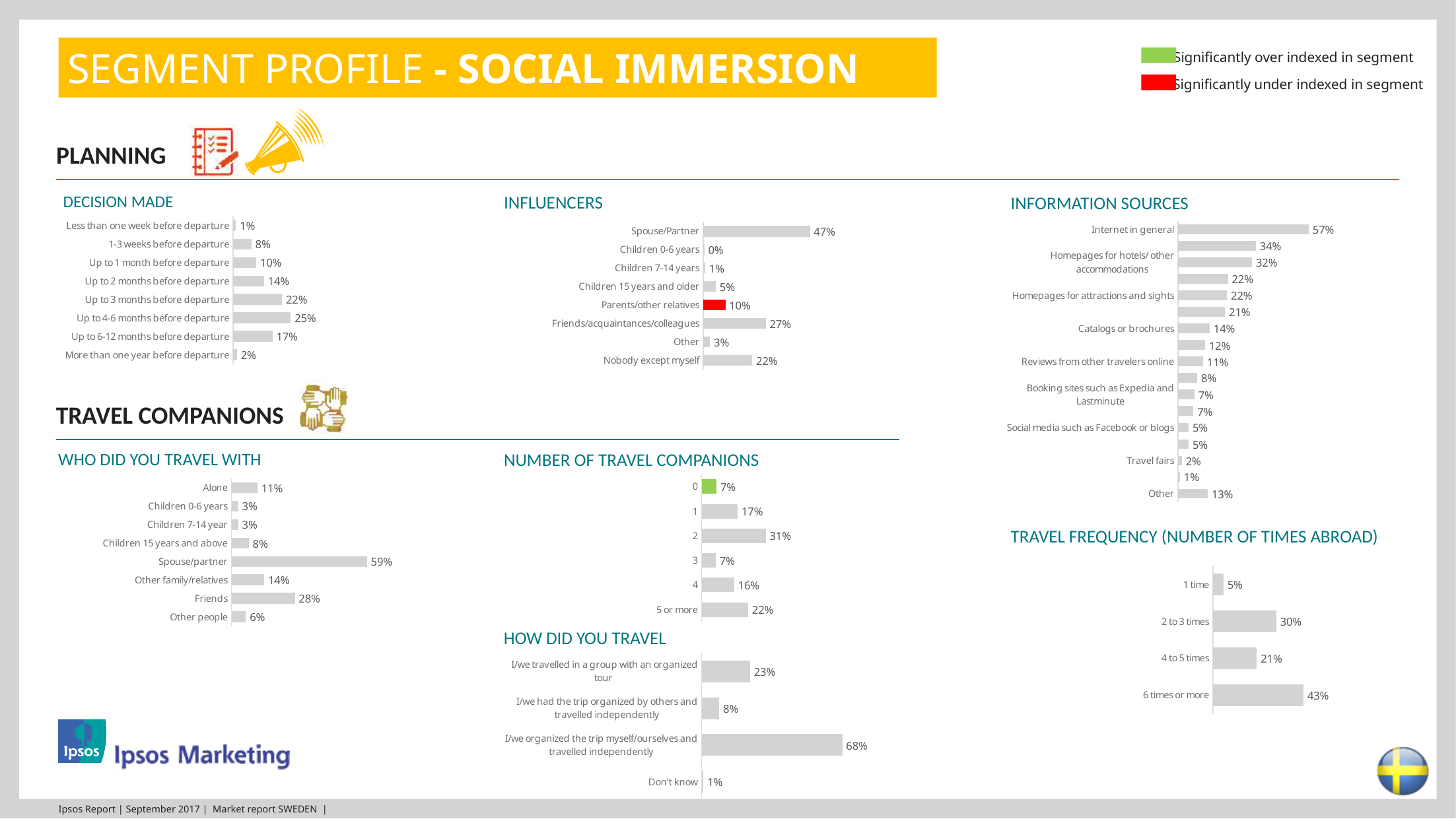
In the WHO DID YOU TRAVEL WITH chart, how many categories are shown? 8 In the HOW DID YOU TRAVEL chart, what is the value for 'I/we organized the trip myself/ourselves and travelled independently'? 68% In the DECISION MADE chart, what is the value for 'Up to 3 months before departure'? 22% In the TRAVEL FREQUENCY (NUMBER OF TIMES ABROAD) chart, which category has the lowest value? 1 time In the INFLUENCERS chart, what is the value for Spouse/Partner? 47% In the WHO DID YOU TRAVEL WITH chart, which is larger, Friends or Other family/relatives? Friends In the DECISION MADE chart, which category has the highest value? Up to 4-6 months before departure In the INFLUENCERS chart, which category is shown with a red bar? Parents/other relatives In the INFLUENCERS chart, what is the difference between Friends/acquaintances/colleagues and Nobody except myself? 5% In the NUMBER OF TRAVEL COMPANIONS chart, what is the value for 2 companions? 31% In the INFORMATION SOURCES chart, what is the value for Catalogs or brochures? 14% In the INFORMATION SOURCES chart, which category has the highest value? Internet in general